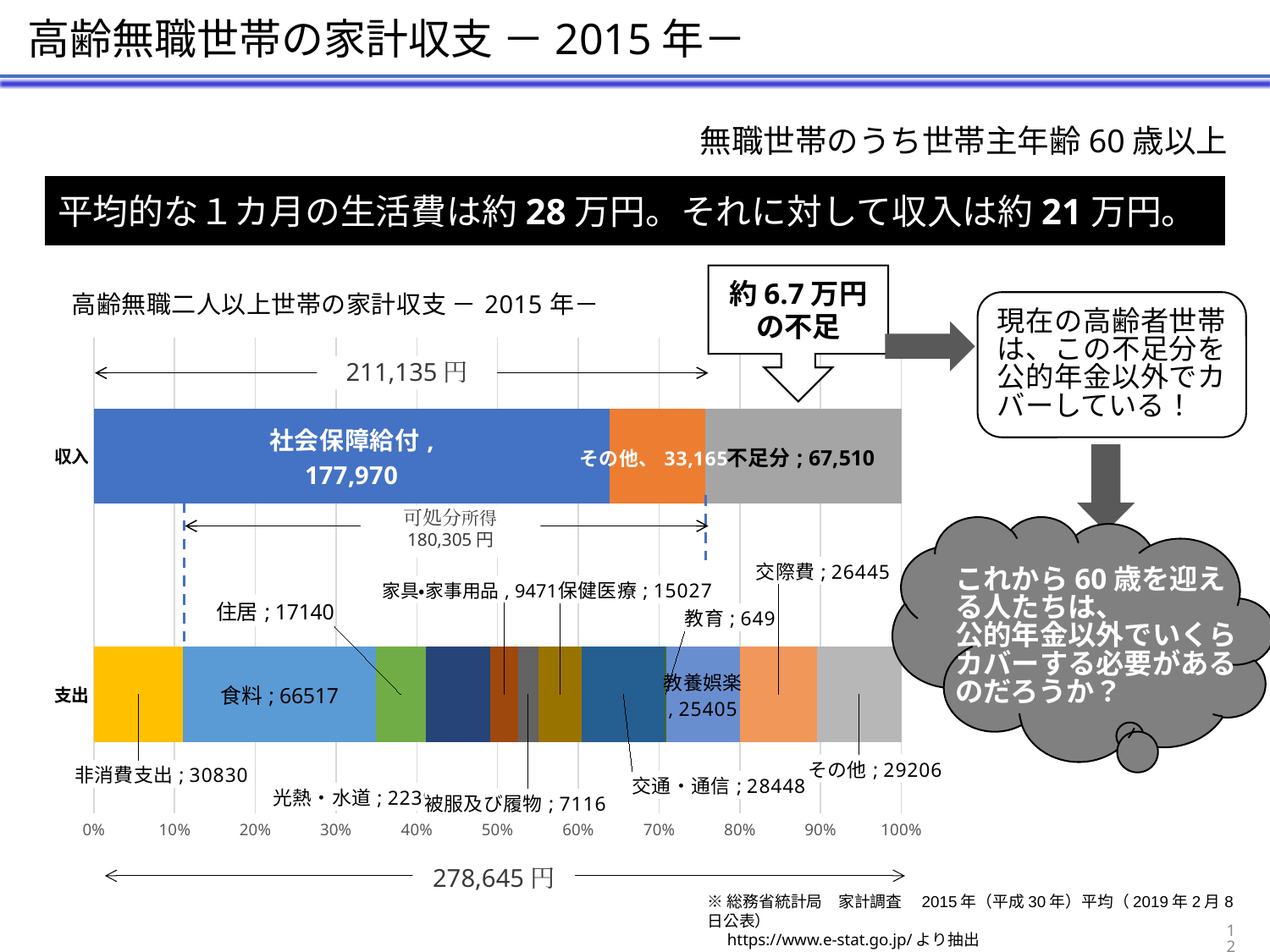
What is the value of 食料 in the 支出 bar? 66517 What is the value of 社会保障給付 in the 収入 bar? 177,970 Which labelled segment of the 支出 bar has the smallest value? 教育 What is the total of the 収入 bar (社会保障給付 + その他 + 不足分)? 278,645 What is the value of 不足分 in the 収入 bar? 67,510 What type of chart is shown on the slide? Stacked bar chart What is the difference between 社会保障給付 and その他 in the 収入 bar? 144,805 Which is larger in the 支出 bar, 非消費支出 or その他? 非消費支出 Is the 社会保障給付 segment of the 収入 bar greater or less than 60% of the bar? greater What is the value of 交通・通信 in the 支出 bar? 28448 Which labelled segment of the 支出 bar has the largest value? 食料 What is the difference between 交際費 and 教養娯楽 in the 支出 bar? 1040